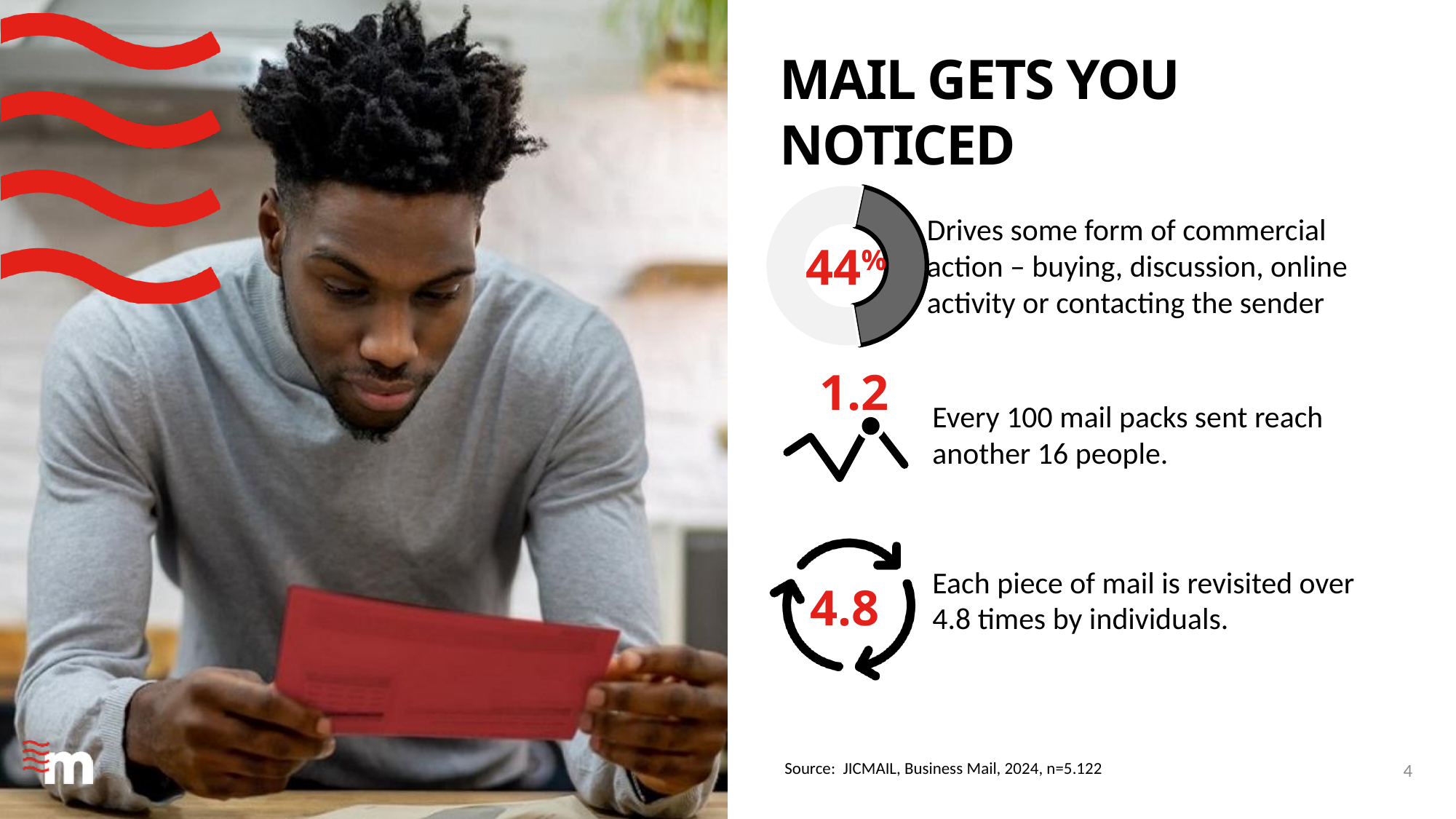
What share of the donut chart does the dark grey segment represent? 44% What value is printed in the centre of the donut chart? 44% Which segment of the donut chart is larger, the dark grey one or the light grey one? light grey What kind of chart is shown next to the text 'Drives some form of commercial action'? donut chart How many segments does the donut chart have? 2 What does the 44% in the donut chart represent, according to the text beside it? Drives some form of commercial action – buying, discussion, online activity or contacting the sender Is the dark grey segment of the donut chart greater or less than 50%? less What share of the donut chart does the light grey segment represent? 56% What colour is the 44% label in the centre of the donut chart? red